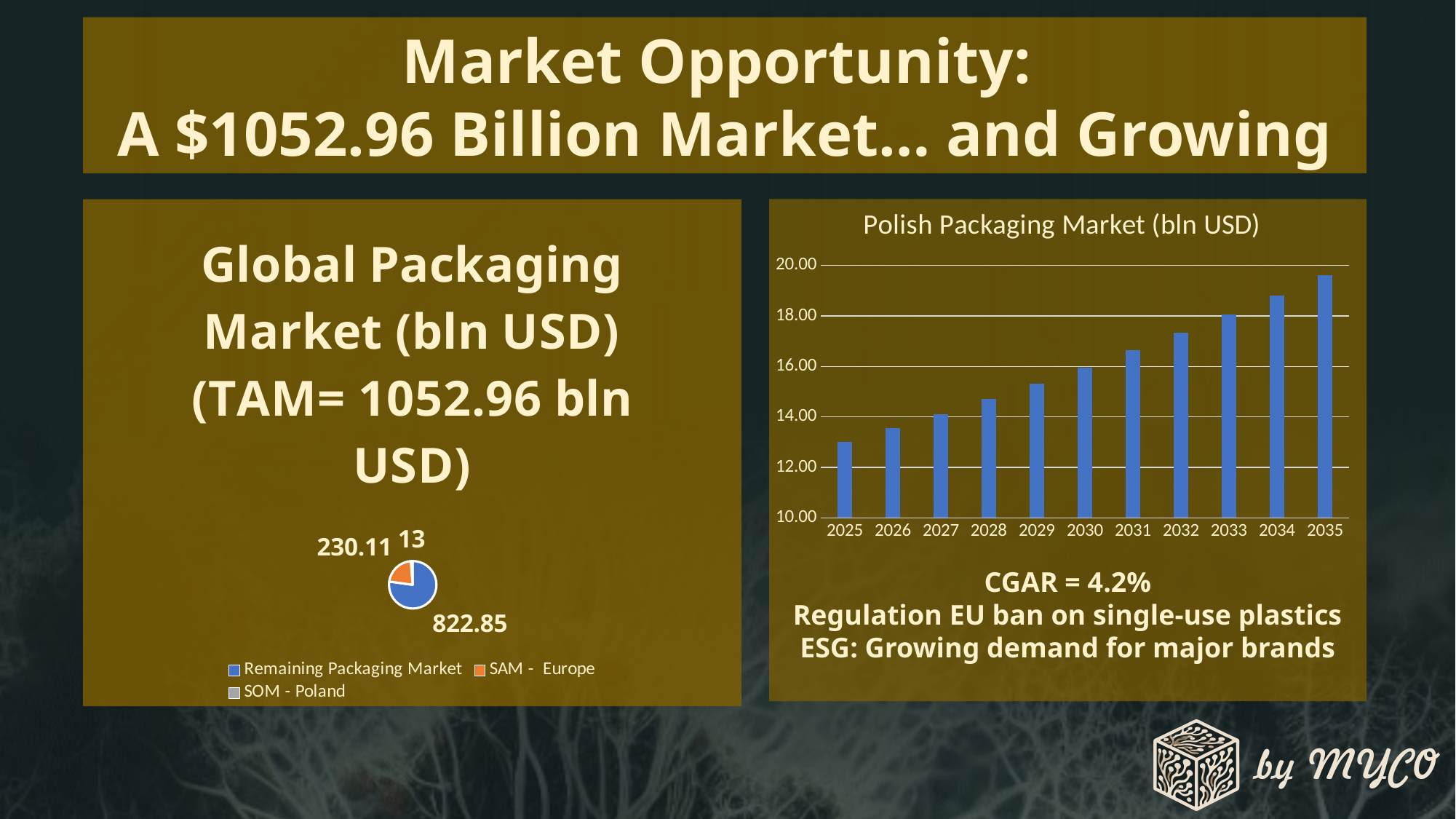
In the Polish Packaging Market chart, do the values rise or fall from 2025 to 2035? rise What kind of chart is the Global Packaging Market chart on the left? pie chart In the Global Packaging Market pie chart, what is the value for SAM - Europe? 230.11 What kind of chart is the Polish Packaging Market chart on the right? bar chart In the Global Packaging Market pie chart, which slice is the smallest? SOM - Poland How many entries does the legend of the Global Packaging Market pie chart list? 3 In the Global Packaging Market pie chart, what is the difference between Remaining Packaging Market and SAM - Europe? 592.74 In the Global Packaging Market pie chart, what is the value for Remaining Packaging Market? 822.85 In the Global Packaging Market pie chart, what is the value for SOM - Poland? 13 How many years are shown on the x axis of the Polish Packaging Market chart? 11 In the Polish Packaging Market chart, is the value for 2025 greater or less than 14.00? less In the Polish Packaging Market chart, is the value for 2035 greater or less than 18.00? greater